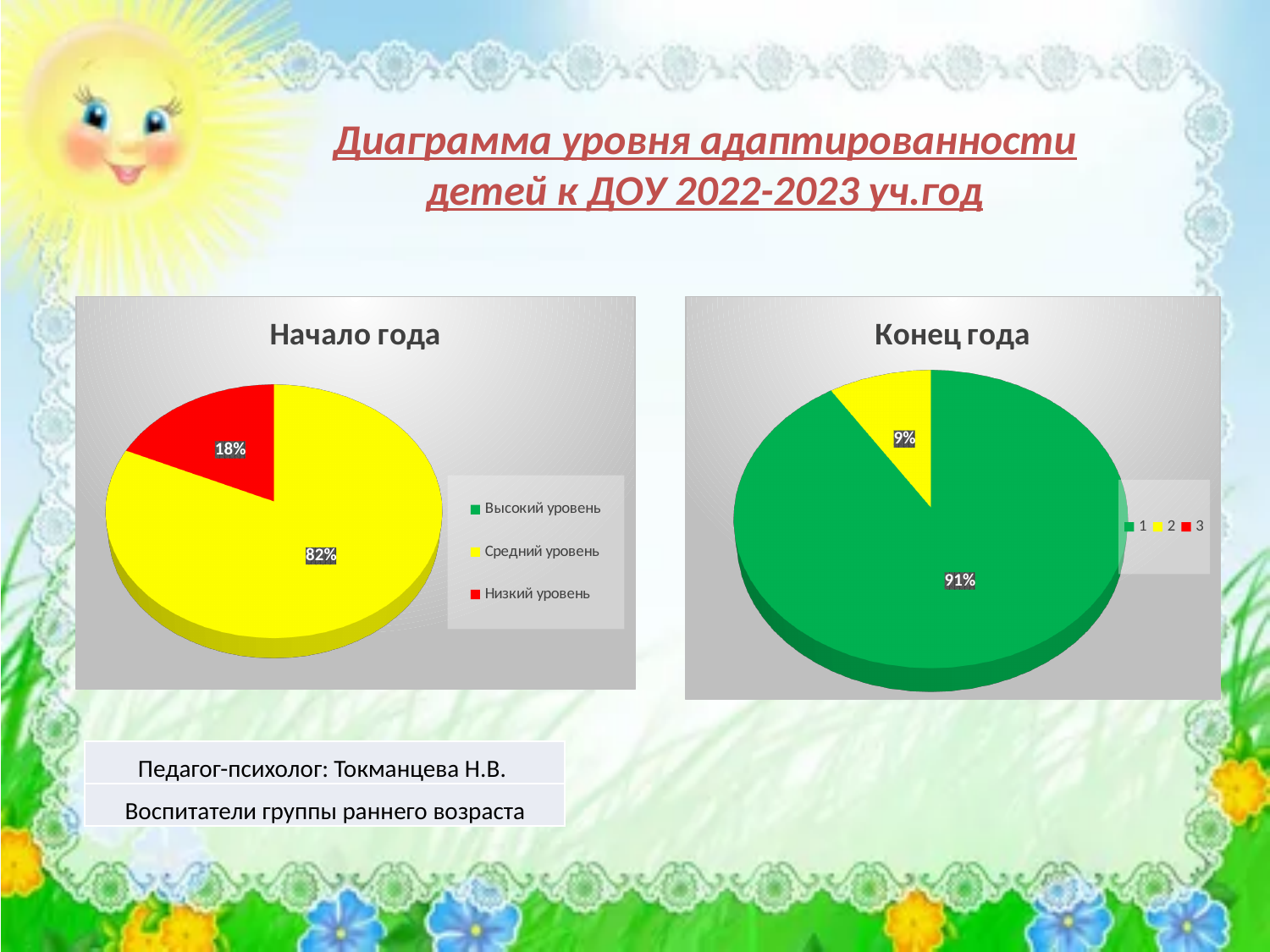
In the "Начало года" chart, what is the difference between the Средний уровень and Низкий уровень shares? 64% In the "Начало года" chart, what percentage is shown for the red slice (Низкий уровень)? 18% In the "Конец года" chart, what is the difference between the green slice and the yellow slice? 82% What type of chart is "Начало года"? pie chart In the "Начало года" chart, what percentage is shown for the yellow slice (Средний уровень)? 82% How many entries does the legend of the "Конец года" chart list? 3 How many entries does the legend of the "Начало года" chart list? 3 In the "Конец года" chart, what percentage is shown for the yellow slice? 9% In the "Конец года" chart, which slice is larger, the green one or the yellow one? the green one In the "Начало года" chart, which level has the largest share? Средний уровень In the "Начало года" chart, which colour represents Низкий уровень? red In the "Конец года" chart, what percentage is shown for the green slice? 91%